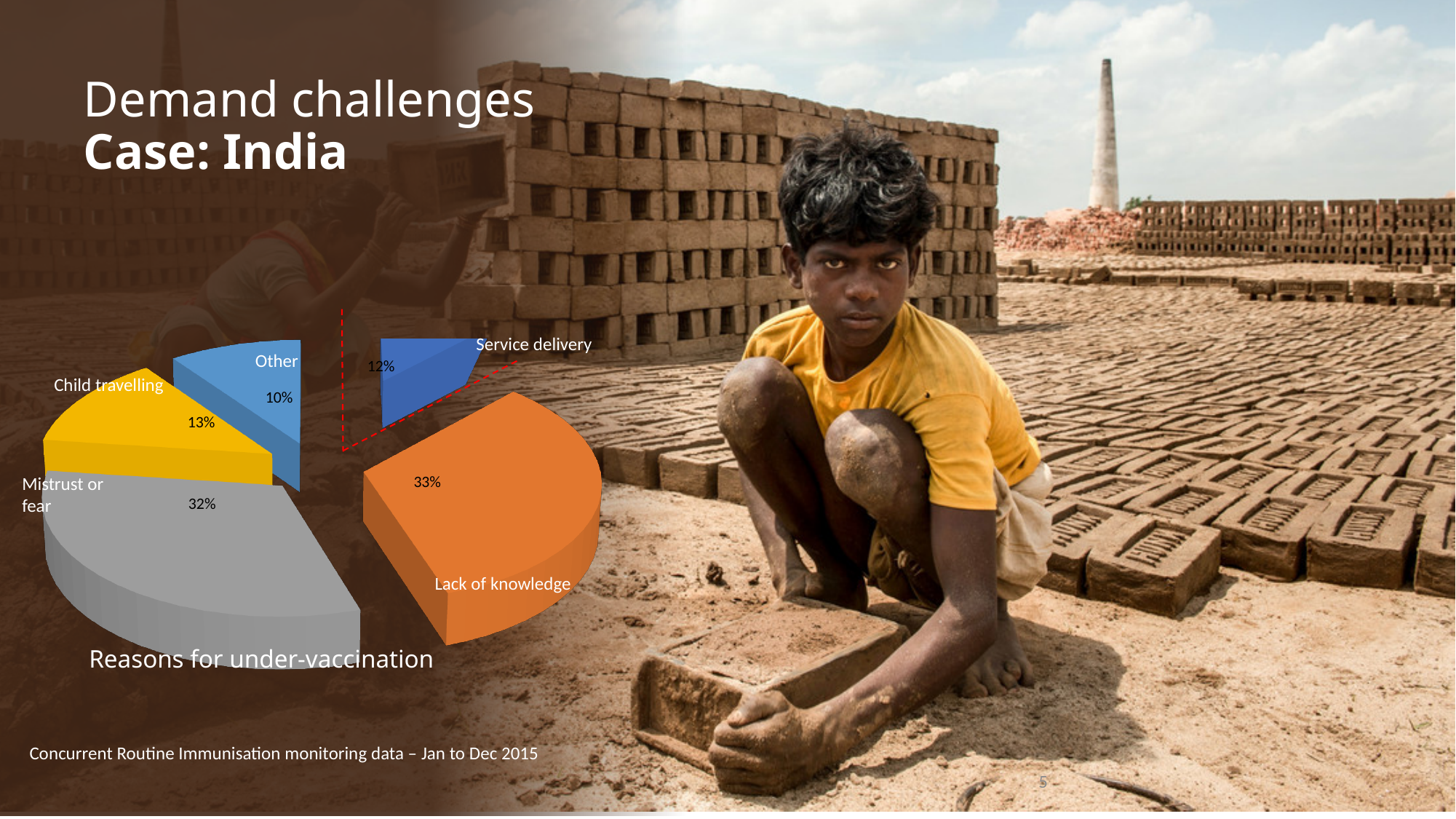
How many slices does the pie chart have? 5 Which reason has the largest share of the pie? Lack of knowledge What is the title of the chart? Reasons for under-vaccination Which reason has the smallest share of the pie? Other What share of the pie is Mistrust or fear? 32% Which is larger, the share for Child travelling or the share for Other? Child travelling What share of the pie is Service delivery? 12% What share of the pie is Child travelling? 13% What kind of chart is shown on the slide? Pie chart What share of the pie is Lack of knowledge? 33% What share of the pie is Other? 10% What is the difference in percentage points between Lack of knowledge and Child travelling? 20